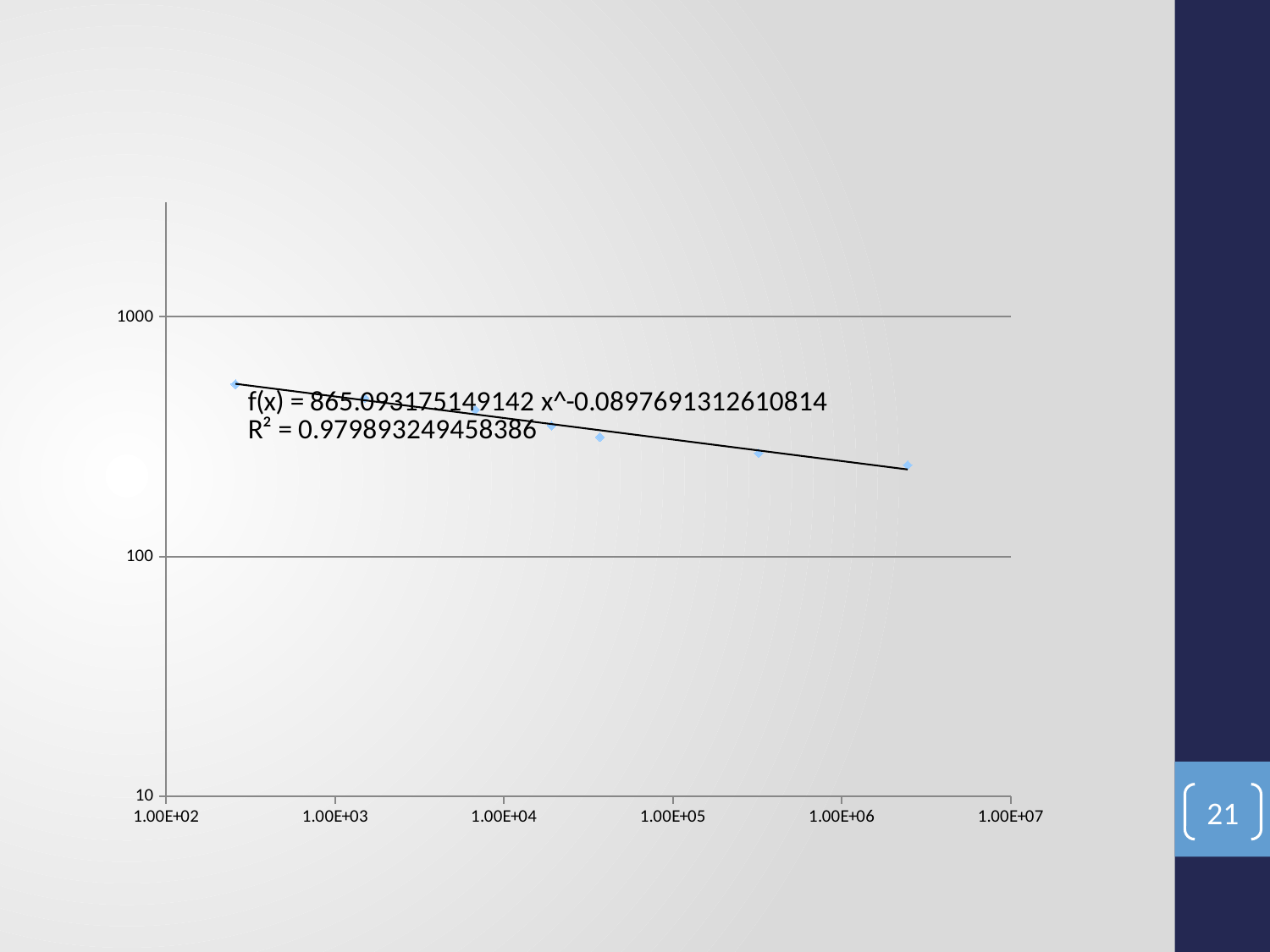
What kind of chart is shown on the slide? scatter chart How many data points are plotted on the chart? 7 What is the lowest tick label shown on the y axis? 10 Is the value of the leftmost data point greater or less than 1000? less What is the R² value shown on the chart? R² = 0.979893249458386 Do the plotted values rise or fall as x increases along the x axis? fall Which data point has the highest y value, the leftmost or the rightmost? the leftmost What is the trendline equation shown on the chart? f(x) = 865.093175149142 x^-0.0897691312610814 Is the value of the leftmost data point greater or less than 100? greater Is the value of the rightmost data point greater or less than 100? greater